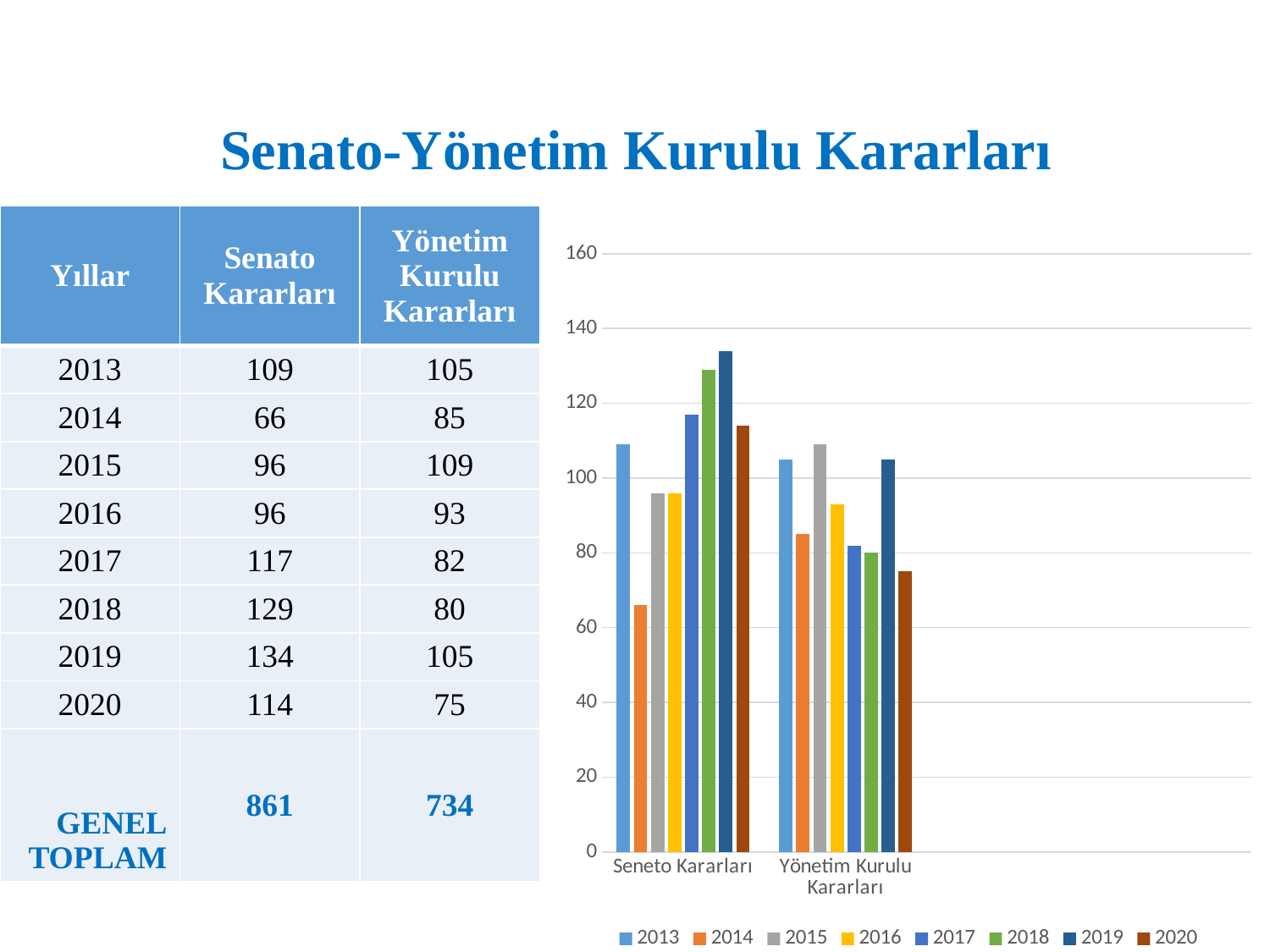
How many categories are shown on the x axis of the chart? 2 What is the value for 2019 in Seneto Kararları? 134 Is the value for 2018 in Seneto Kararları greater or less than 120? greater Which year has the highest bar for Seneto Kararları? 2019 How many series does the chart legend list? 8 Is the value for 2014 in Seneto Kararları greater or less than 80? less For 2017, which category has the larger value, Seneto Kararları or Yönetim Kurulu Kararları? Seneto Kararları What is the difference between the 2019 and 2018 values for Seneto Kararları? 5 Which year has the lowest bar for Seneto Kararları? 2014 What kind of chart is shown on the slide? bar chart Is the value for 2020 in Yönetim Kurulu Kararları greater or less than 80? less What colour represents 2016 in the chart legend? yellow